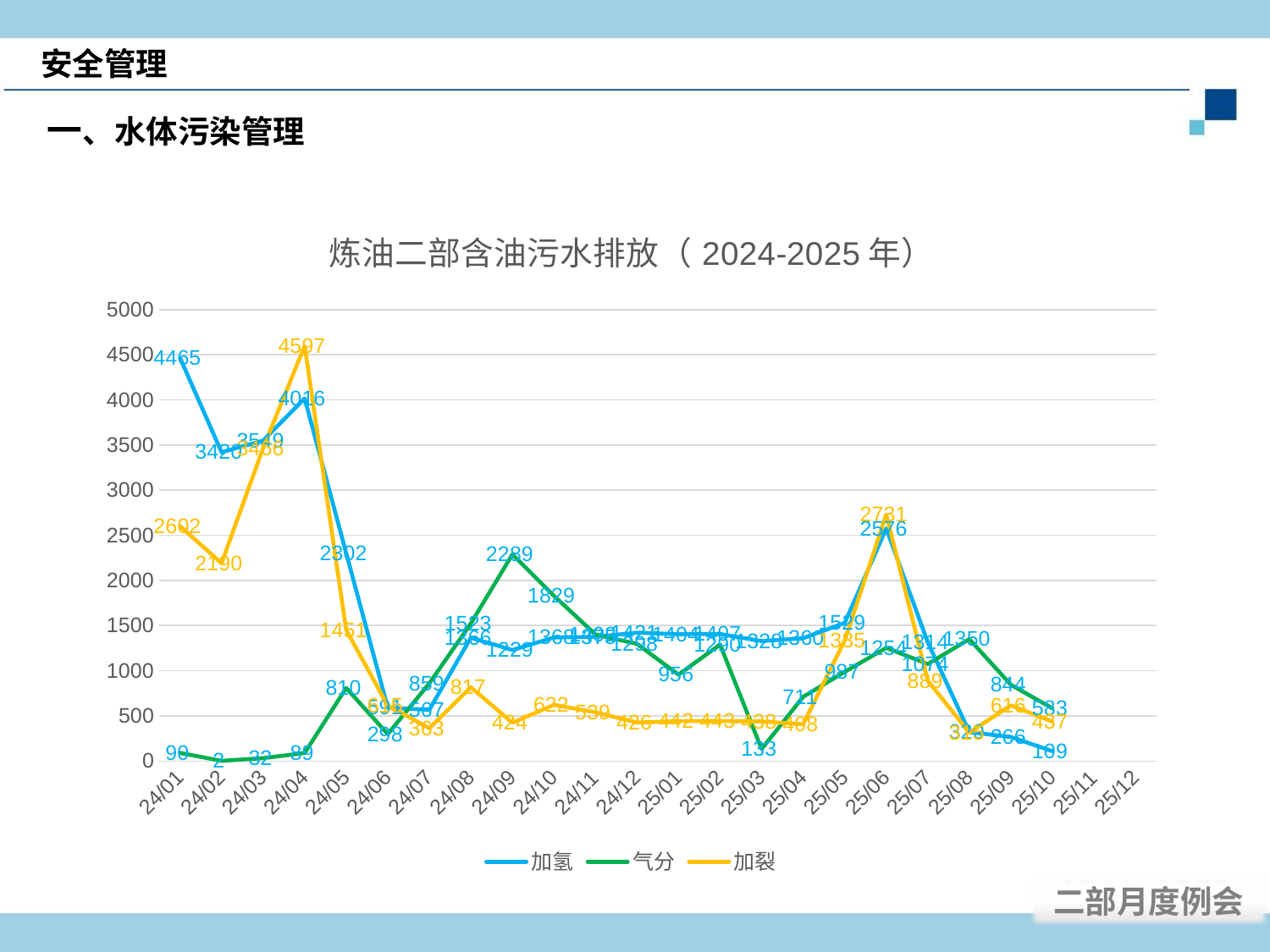
What is the value of 加氢 in 24/01? 4465 What is the difference between the 加裂 values in 24/01 and 24/02? 412 What is the value of 加裂 in 24/04? 4597 What is the value of 气分 in 24/09? 2289 In which month is 气分 at its lowest value? 24/02 How many months are shown on the x axis? 24 Does the 加氢 series rise or fall from 25/06 to 25/10? Fall What is the value of 加氢 in 25/10? 109 In 25/06, which series has the larger value, 加裂 or 加氢? 加裂 What kind of chart is shown on the slide? Line chart How many series does the legend list? 3 In which month does 加裂 reach its highest value? 24/04